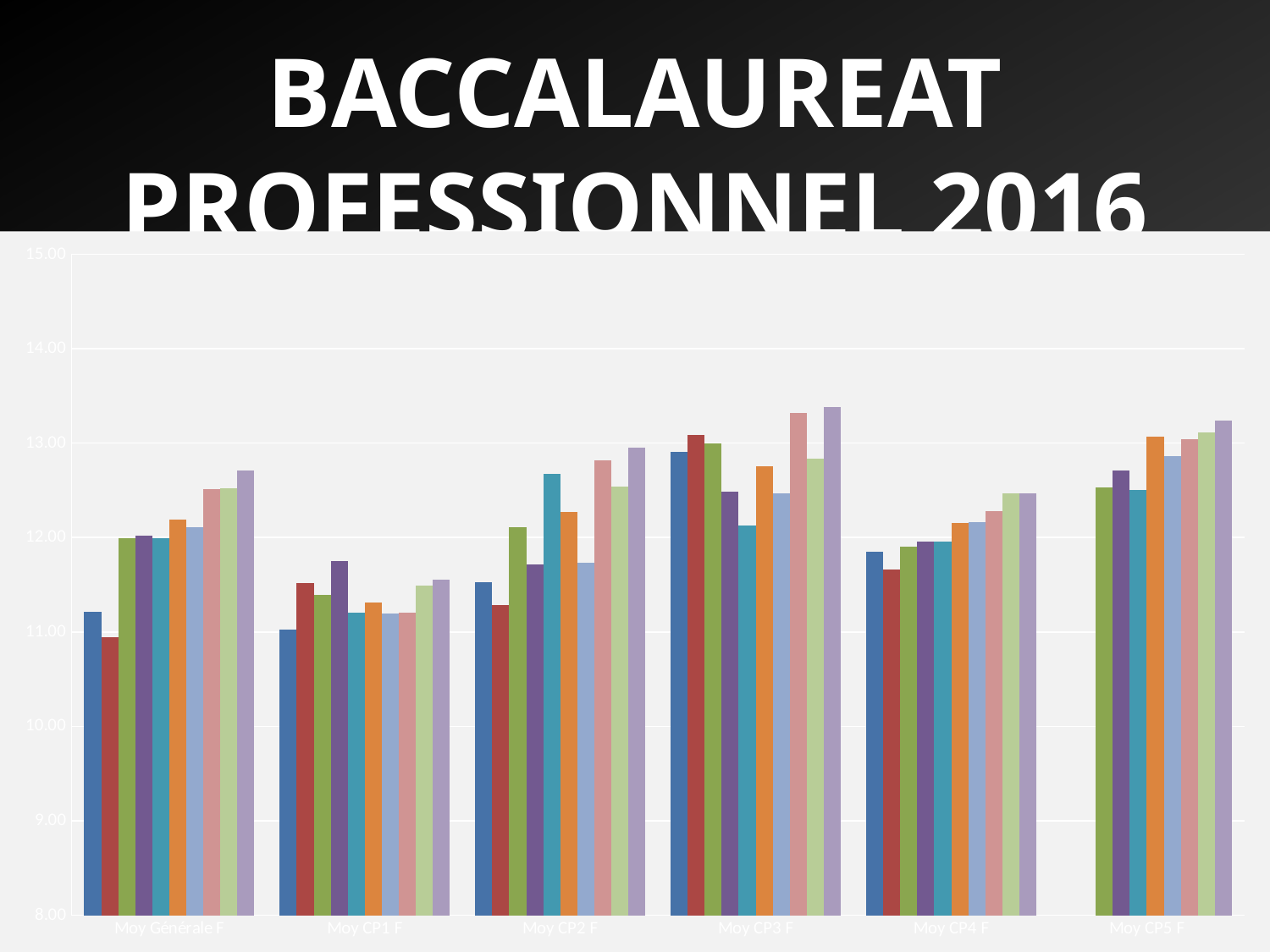
Are all the bars for Moy CP5 F greater or less than 12.00? greater What is the lowest value shown on the y axis of the chart? 8.00 How many categories are shown along the x axis of the chart? 6 Is the tallest bar for Moy CP3 F greater or less than 13.00? greater Is the tallest bar for Moy Générale F greater or less than 13.00? less Which category contains the tallest bar in the chart? Moy CP3 F What is the title of the slide containing the chart? BACCALAUREAT PROFESSIONNEL 2016 What kind of chart is shown on the slide? bar chart Which category has the lowest bars overall in the chart? Moy CP1 F Are the bars for Moy CP3 F taller or shorter than the bars for Moy CP1 F? taller